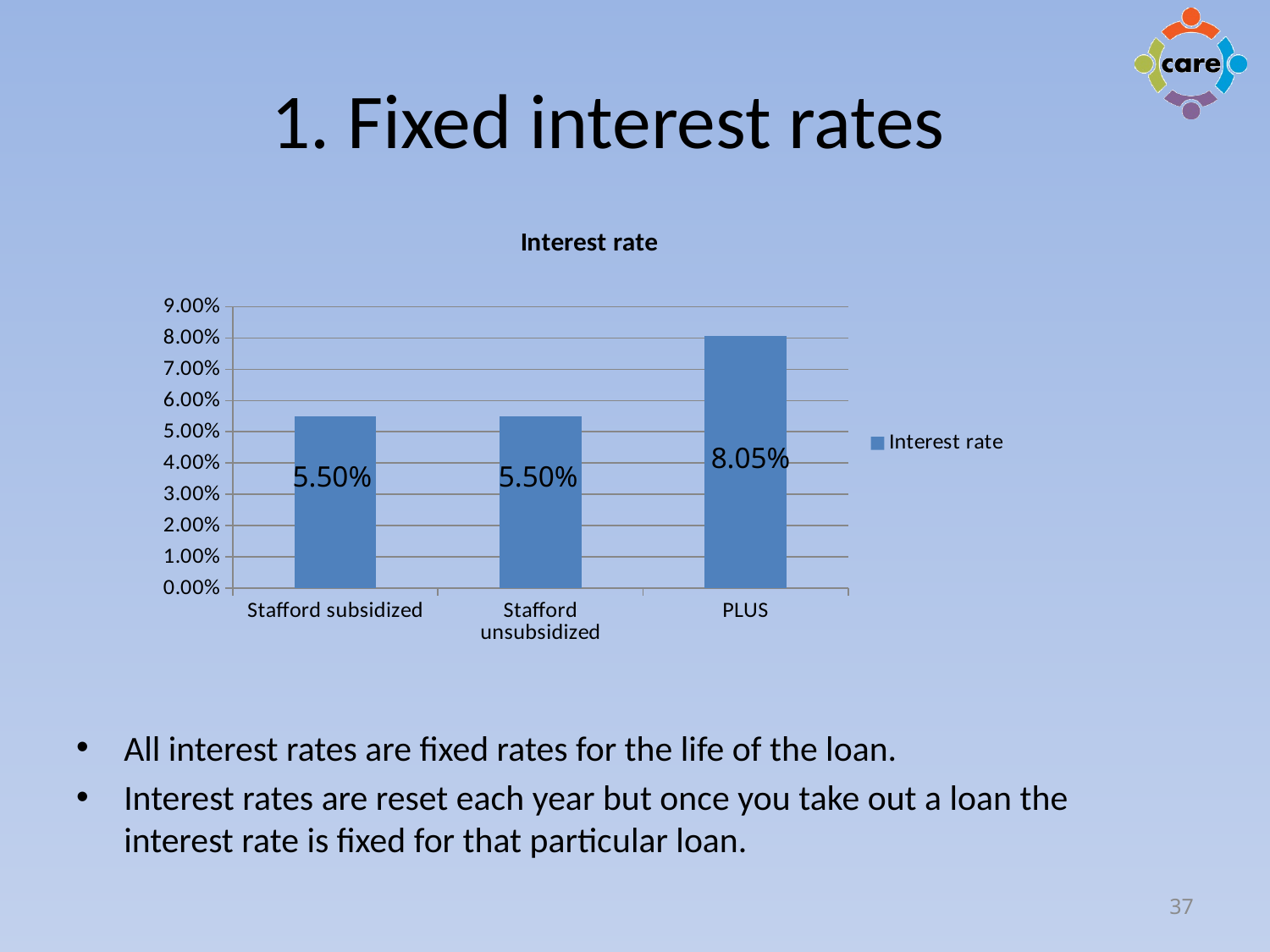
Is the interest rate for Stafford subsidized greater or less than 6.00%? less Which is larger, the interest rate for PLUS or for Stafford unsubsidized? PLUS Which loan type has the highest interest rate? PLUS What is the title of the chart? Interest rate What is the interest rate for Stafford unsubsidized loans? 5.50% How many series does the legend list? 1 What is the difference between the PLUS interest rate and the Stafford subsidized interest rate? 2.55% How many loan types are shown on the chart? 3 What is the interest rate for PLUS loans? 8.05% What is the interest rate for Stafford subsidized loans? 5.50% Is the interest rate for PLUS greater or less than 7.00%? greater What kind of chart is shown on the slide? Bar chart